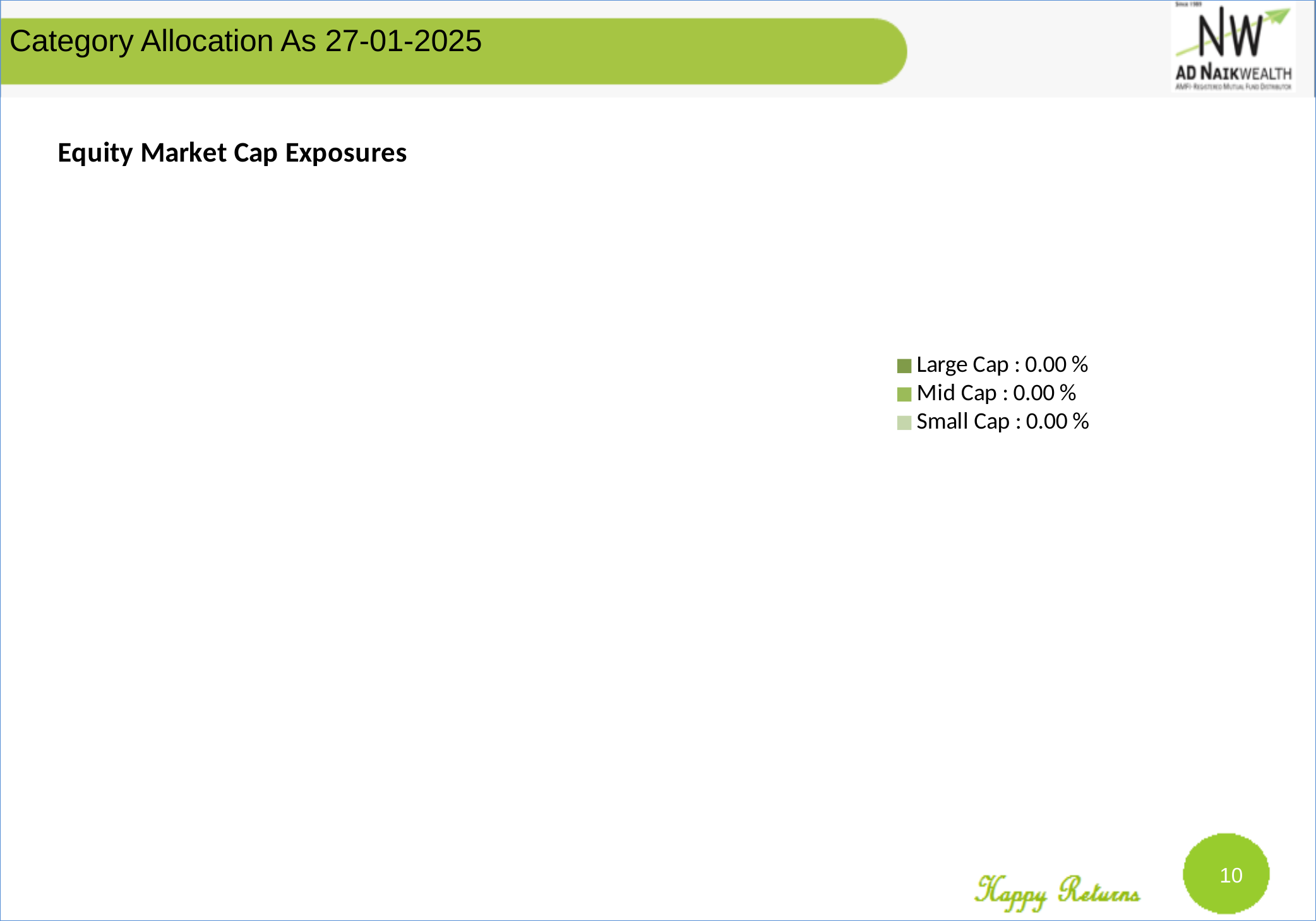
What value does the legend show for Large Cap? 0.00 % What is the heading above the chart area? Equity Market Cap Exposures What is the difference between the Large Cap and Mid Cap values shown in the legend? 0.00 % What value does the legend show for Mid Cap? 0.00 % How many market cap categories are shown in the legend? 3 Which legend entry is listed first? Large Cap : 0.00 % What value does the legend show for Small Cap? 0.00 % How many entries does the chart legend list? 3